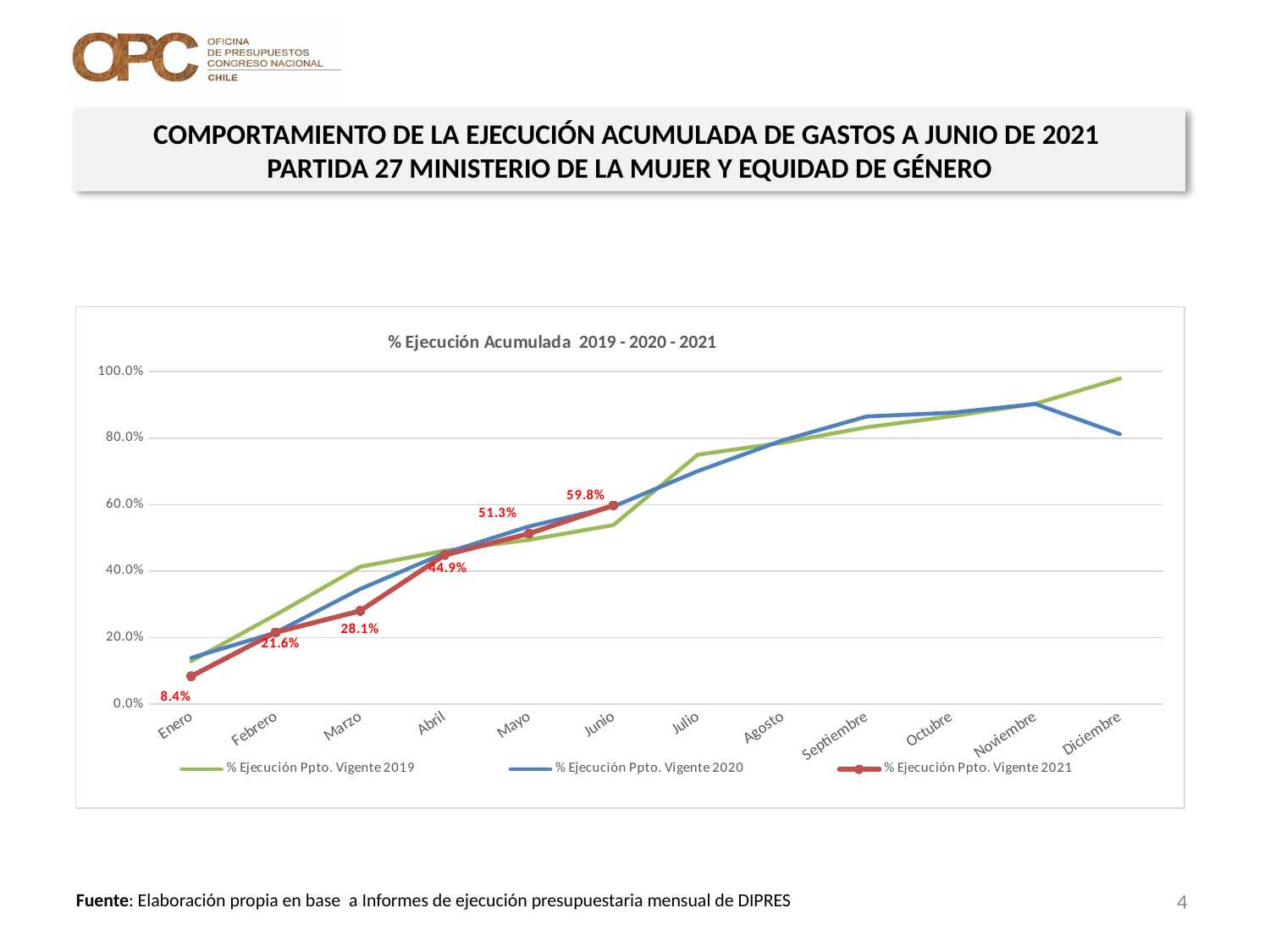
What is the value for Enero in the % Ejecución Ppto. Vigente 2021 series? 8.4% What is the difference in percentage points between Junio and Mayo in the % Ejecución Ppto. Vigente 2021 series? 8.5 How many months are shown on the x axis of the chart? 12 In the % Ejecución Ppto. Vigente 2021 series, which month has the lowest value? Enero How many series does the chart legend list? 3 In the % Ejecución Ppto. Vigente 2021 series, which month has the highest value? Junio What is the value for Abril in the % Ejecución Ppto. Vigente 2021 series? 44.9% In Diciembre, which series has the larger value: % Ejecución Ppto. Vigente 2019 or % Ejecución Ppto. Vigente 2020? % Ejecución Ppto. Vigente 2019 Is the value for Diciembre in the % Ejecución Ppto. Vigente 2019 series greater or less than 80.0%? greater What is the value for Junio in the % Ejecución Ppto. Vigente 2021 series? 59.8% What kind of chart is shown on the slide? Line chart What is the value for Marzo in the % Ejecución Ppto. Vigente 2021 series? 28.1%